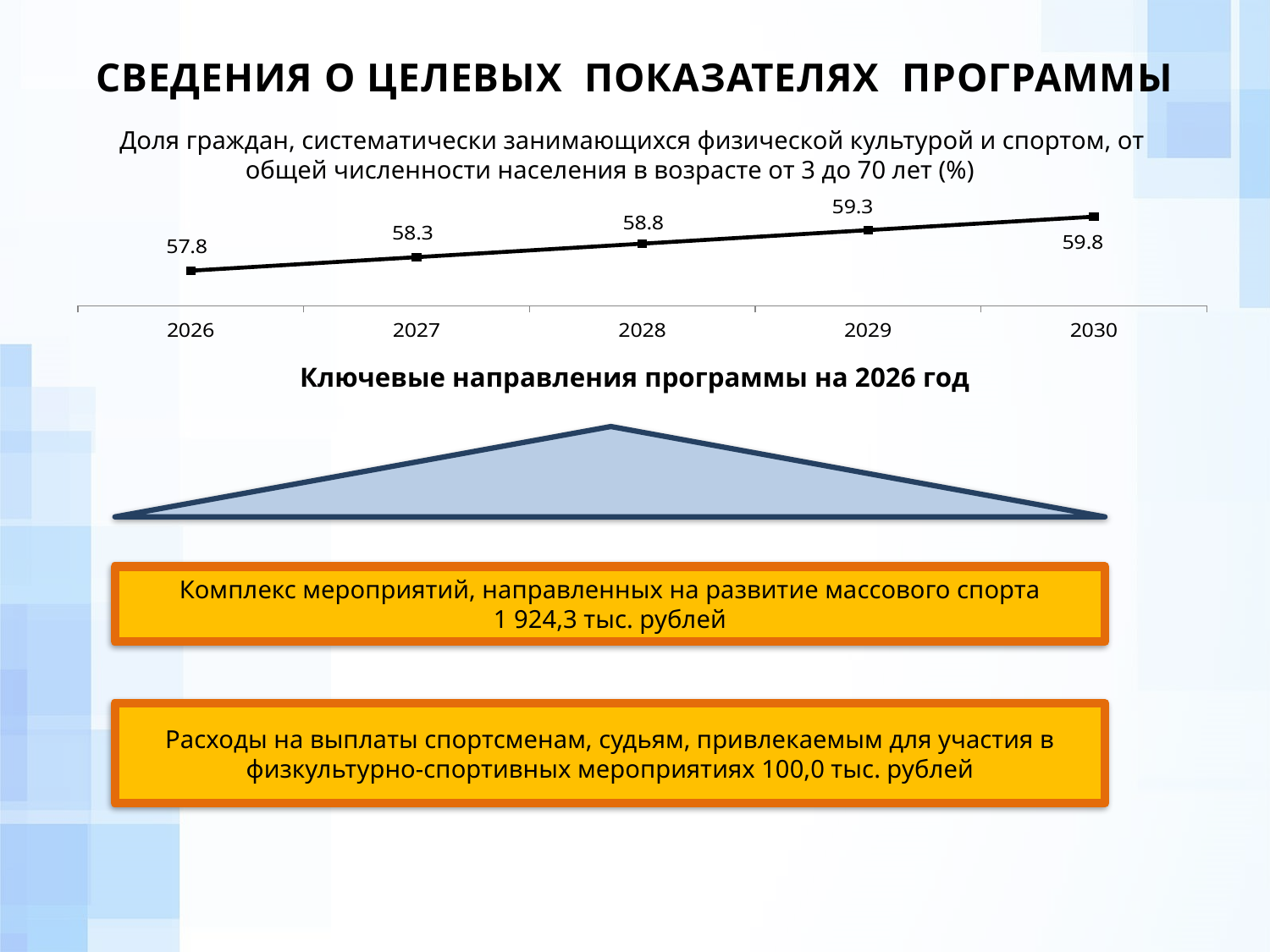
How many years are plotted on the chart? 5 What is the value for 2030? 59.8 Which is larger, the value for 2027 or the value for 2029? 2029 What is the difference between the values for 2030 and 2026? 2.0 What kind of chart is shown? line chart What is the title of the chart? Доля граждан, систематически занимающихся физической культурой и спортом, от общей численности населения в возрасте от 3 до 70 лет (%) Do the values rise or fall from 2026 to 2030? rise Which year has the highest value? 2030 Which year has the lowest value? 2026 What is the value for 2026? 57.8 What is the difference between the values for 2029 and 2027? 1.0 What is the value for 2028? 58.8